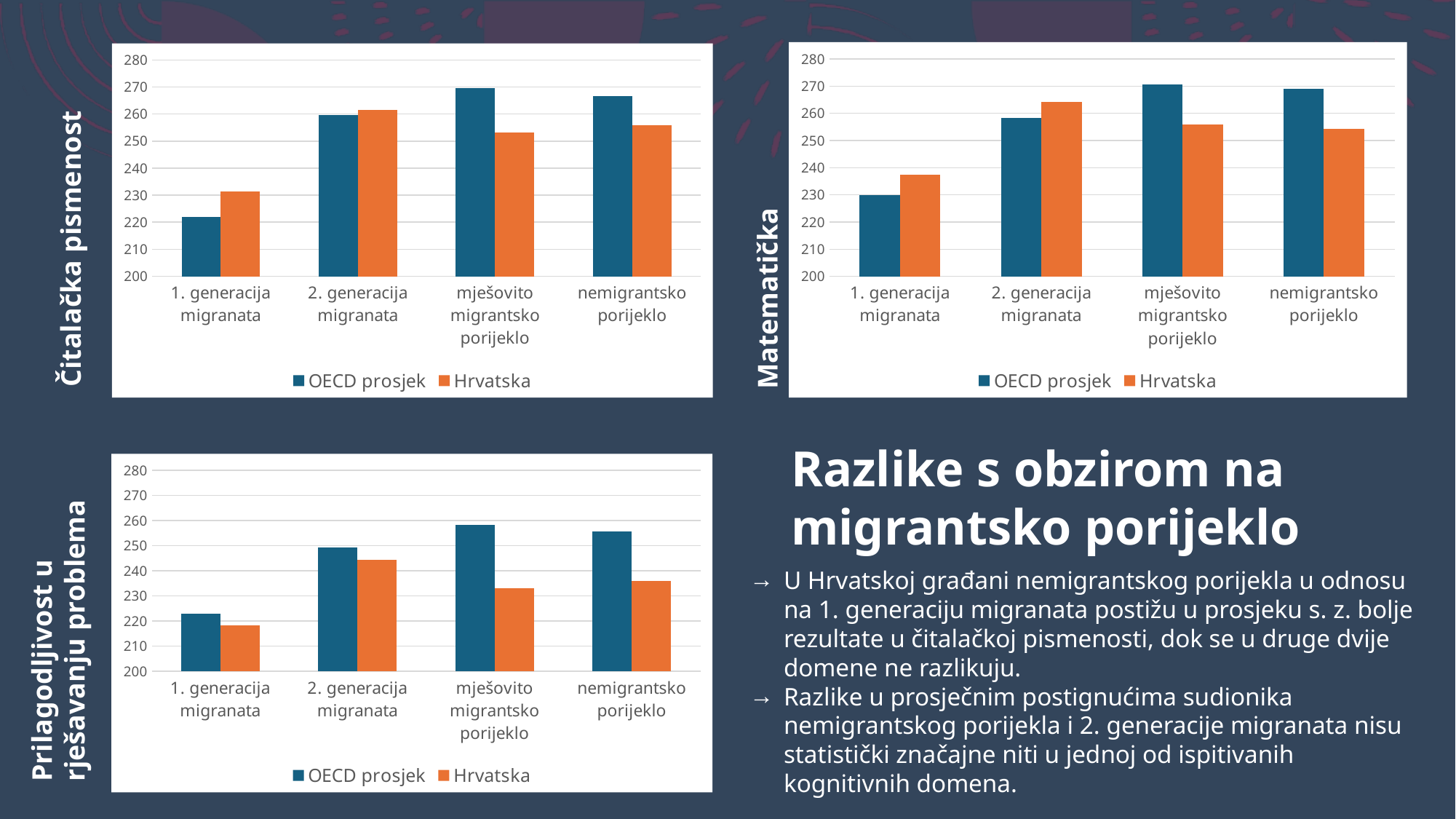
In the 'Matematička' chart, which category has the lowest Hrvatska value? 1. generacija migranata How many categories are shown on the x axis of the 'Matematička' chart? 4 In the 'Čitalačka pismenost' chart, which is larger for '1. generacija migranata': OECD prosjek or Hrvatska? Hrvatska In the 'Matematička' chart, which is larger for 'mješovito migrantsko porijeklo': OECD prosjek or Hrvatska? OECD prosjek How many series does the legend of the 'Prilagodljivost u rješavanju problema' chart list? 2 In the 'Čitalačka pismenost' chart, which category has the highest OECD prosjek value? mješovito migrantsko porijeklo In the 'Prilagodljivost u rješavanju problema' chart, which category has the lowest Hrvatska value? 1. generacija migranata What are the two legend entries in the 'Prilagodljivost u rješavanju problema' chart? OECD prosjek, Hrvatska In the 'Matematička' chart, is the Hrvatska value for '2. generacija migranata' greater or less than 260? greater What kind of chart is the 'Čitalačka pismenost' chart? bar chart In the 'Prilagodljivost u rješavanju problema' chart, is the OECD prosjek value for 'mješovito migrantsko porijeklo' greater or less than 250? greater In the 'Čitalačka pismenost' chart, is the OECD prosjek value for '1. generacija migranata' greater or less than 230? less